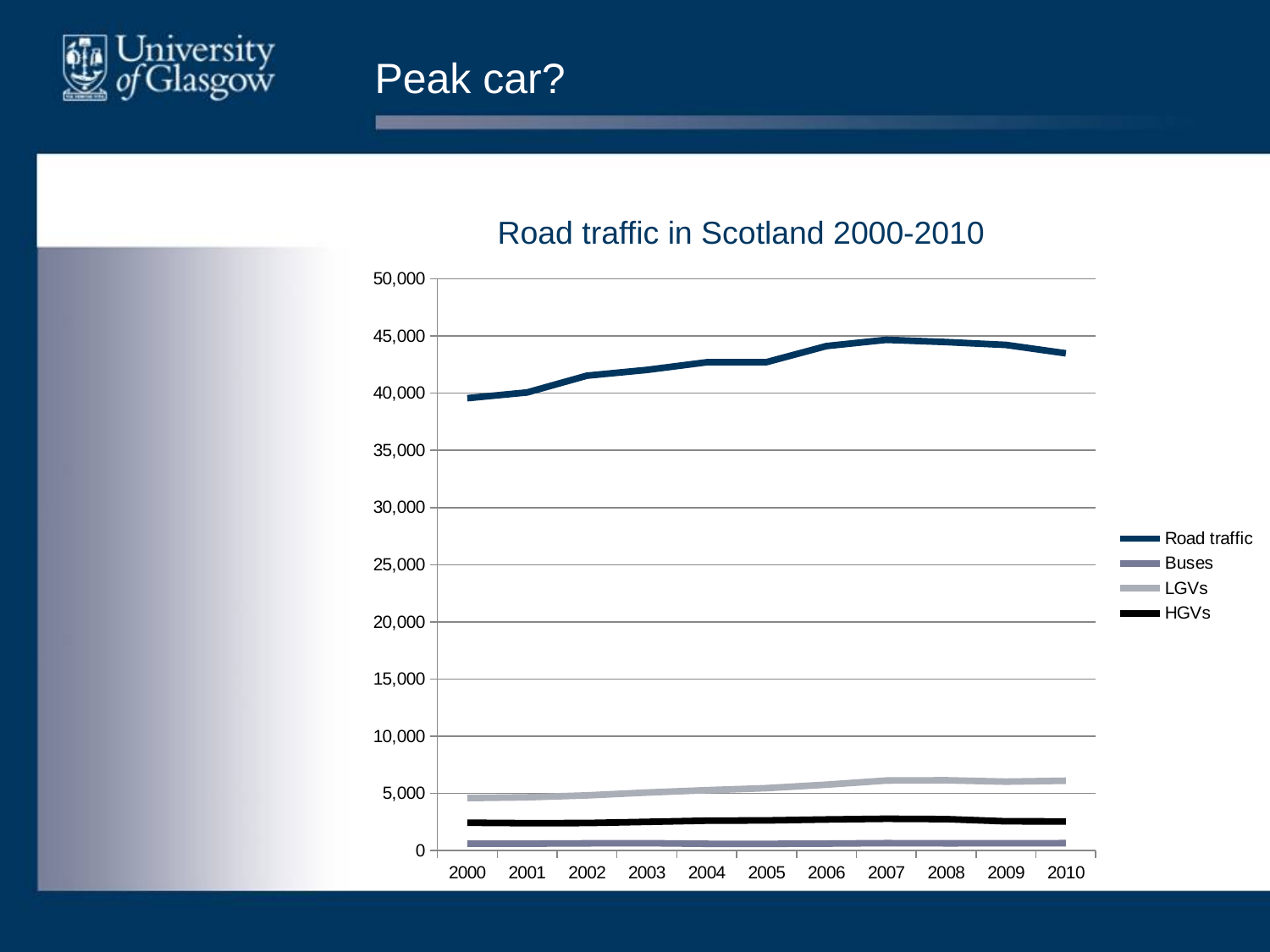
What is the title of the chart? Road traffic in Scotland 2000-2010 Does the Road traffic series rise or fall between 2000 and 2007? Rise In 2008, which is larger, the value for LGVs or the value for HGVs? LGVs Which series has the lowest values across the chart? Buses How many years are plotted along the x axis? 11 How many series does the legend list? 4 Is the value for Road traffic in 2010 greater or less than 45,000? less Is the value for HGVs in 2005 greater or less than 5,000? less Is the value for LGVs in 2010 greater or less than 5,000? greater Which series has the highest values across the chart? Road traffic What kind of chart is shown on the slide? Line chart